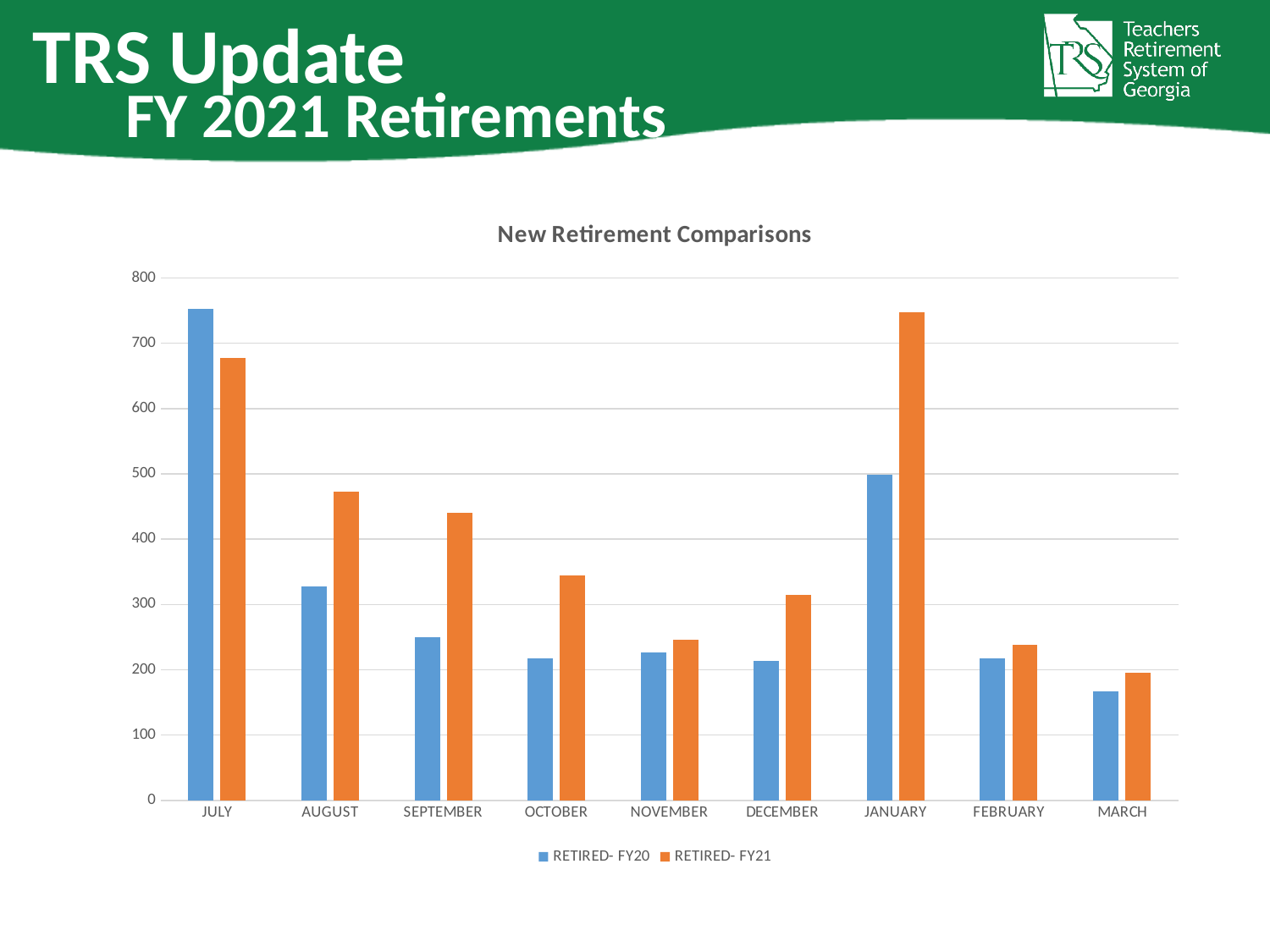
How many series does the legend list? 2 What kind of chart is shown on the slide? Bar chart What is the title of the chart? New Retirement Comparisons Which month has the lowest value for RETIRED- FY21? MARCH Is the RETIRED- FY20 value for JULY greater or less than 700? greater How many months are shown on the x axis? 9 Which month has the highest value for RETIRED- FY21? JANUARY In JANUARY, which series has the larger value, RETIRED- FY20 or RETIRED- FY21? RETIRED- FY21 Which month has the lowest value for RETIRED- FY20? MARCH In JULY, which series has the larger value, RETIRED- FY20 or RETIRED- FY21? RETIRED- FY20 Is the RETIRED- FY21 value for AUGUST greater or less than 500? less Which month has the highest value for RETIRED- FY20? JULY